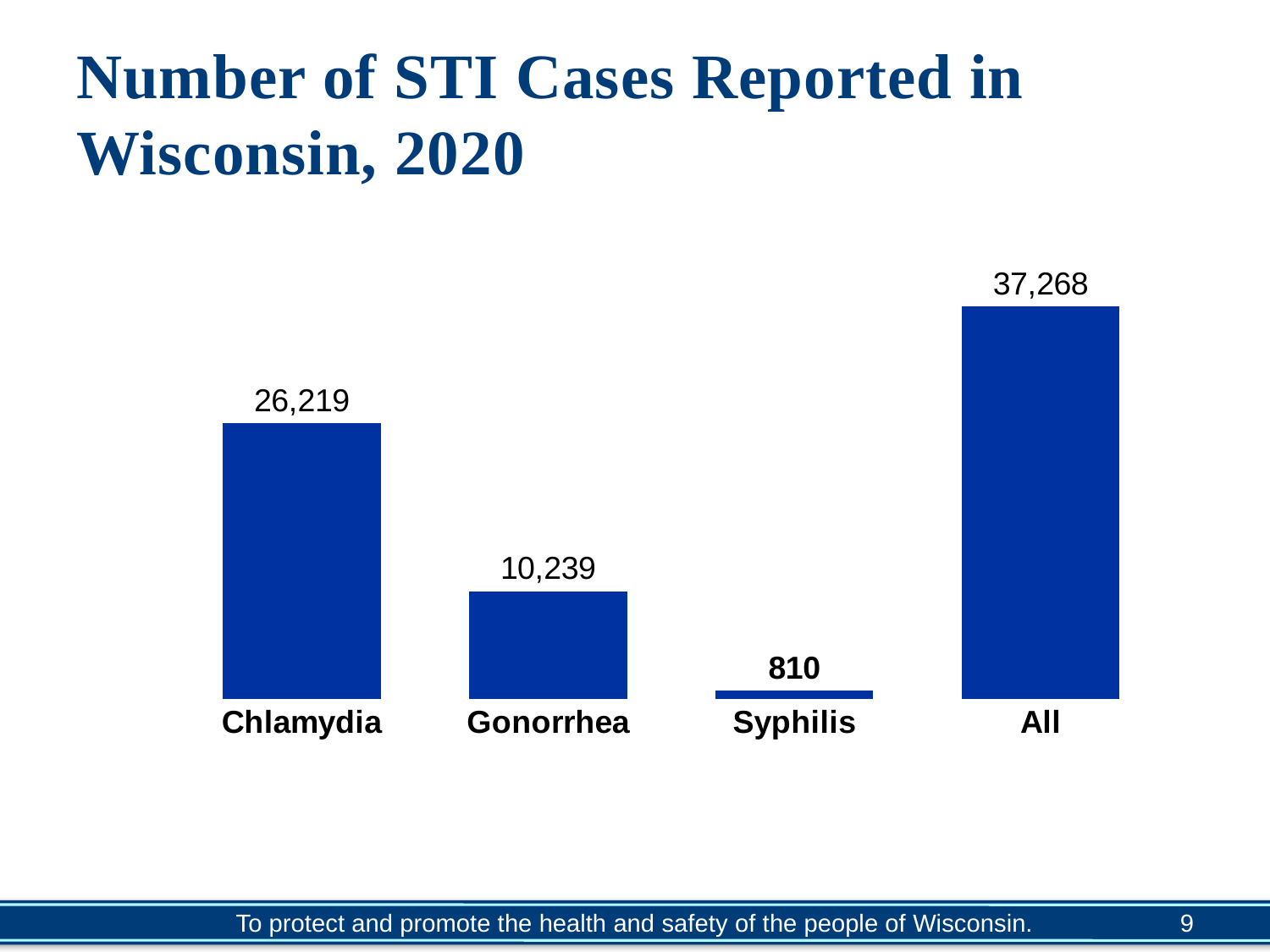
Which has more reported cases, gonorrhea or syphilis? Gonorrhea How many syphilis cases are shown on the chart? 810 What is the title of the slide? Number of STI Cases Reported in Wisconsin, 2020 What colour are the bars in the chart? Blue What is the number of gonorrhea cases shown on the chart? 10,239 What type of chart is shown on the slide? Bar chart Which category has the highest number of cases? All What is the difference between the number of chlamydia cases and gonorrhea cases? 15,980 How many chlamydia cases were reported in Wisconsin in 2020 according to the chart? 26,219 Which STI has the fewest reported cases? Syphilis What is the value of the 'All' bar? 37,268 How many categories are shown on the chart? 4